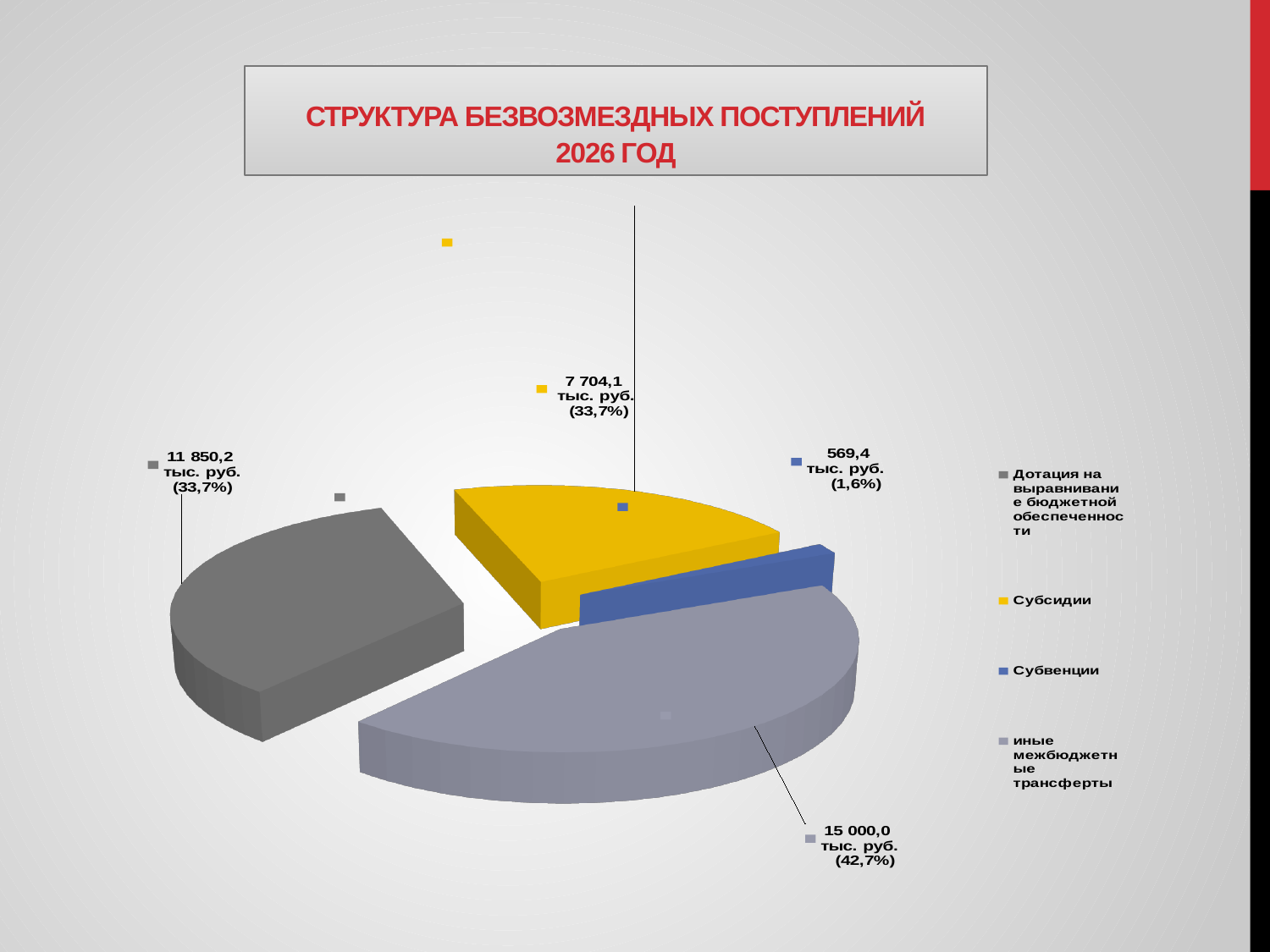
Which category has the largest slice of the pie? иные межбюджетные трансферты What is the value for Субвенции? 569,4 тыс. руб. What share of the pie does Субвенции represent? 1,6% What is the value for Дотация на выравнивание бюджетной обеспеченности? 11 850,2 тыс. руб. Which category has the smallest slice of the pie? Субвенции What is the value for Субсидии? 7 704,1 тыс. руб. What share of the pie does иные межбюджетные трансферты represent? 42,7% What kind of chart is shown on the slide? Pie chart How many slices does the pie chart have? 4 Which is larger, the value for Дотация на выравнивание бюджетной обеспеченности or the value for Субсидии? Дотация на выравнивание бюджетной обеспеченности What is the value for иные межбюджетные трансферты? 15 000,0 тыс. руб. What is the title of the chart? СТРУКТУРА БЕЗВОЗМЕЗДНЫХ ПОСТУПЛЕНИЙ 2026 ГОД